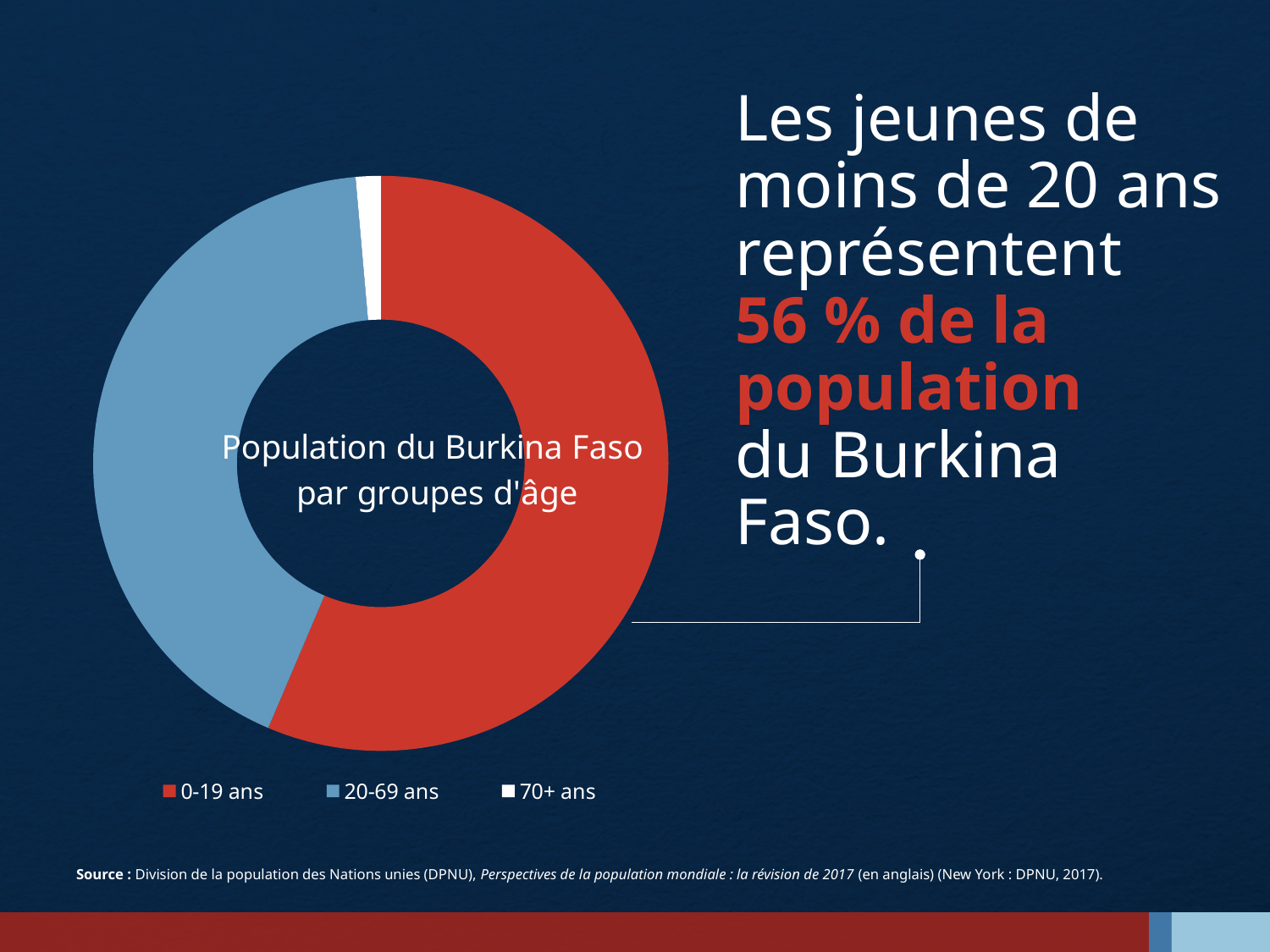
What colour represents the 0-19 ans group in the chart? Red Which is larger, the share for 20-69 ans or the share for 70+ ans? 20-69 ans According to the slide, what share of the population of Burkina Faso is under 20 years old (0-19 ans)? 56 % What is the title of the chart? Population du Burkina Faso par groupes d'âge How many entries does the legend list? 3 How many age groups does the chart show? 3 What kind of chart is shown on the slide? Donut (pie) chart Which age group has the largest share of the population? 0-19 ans Which is larger, the share for 0-19 ans or the share for 20-69 ans? 0-19 ans Which age group has the smallest share of the population? 70+ ans